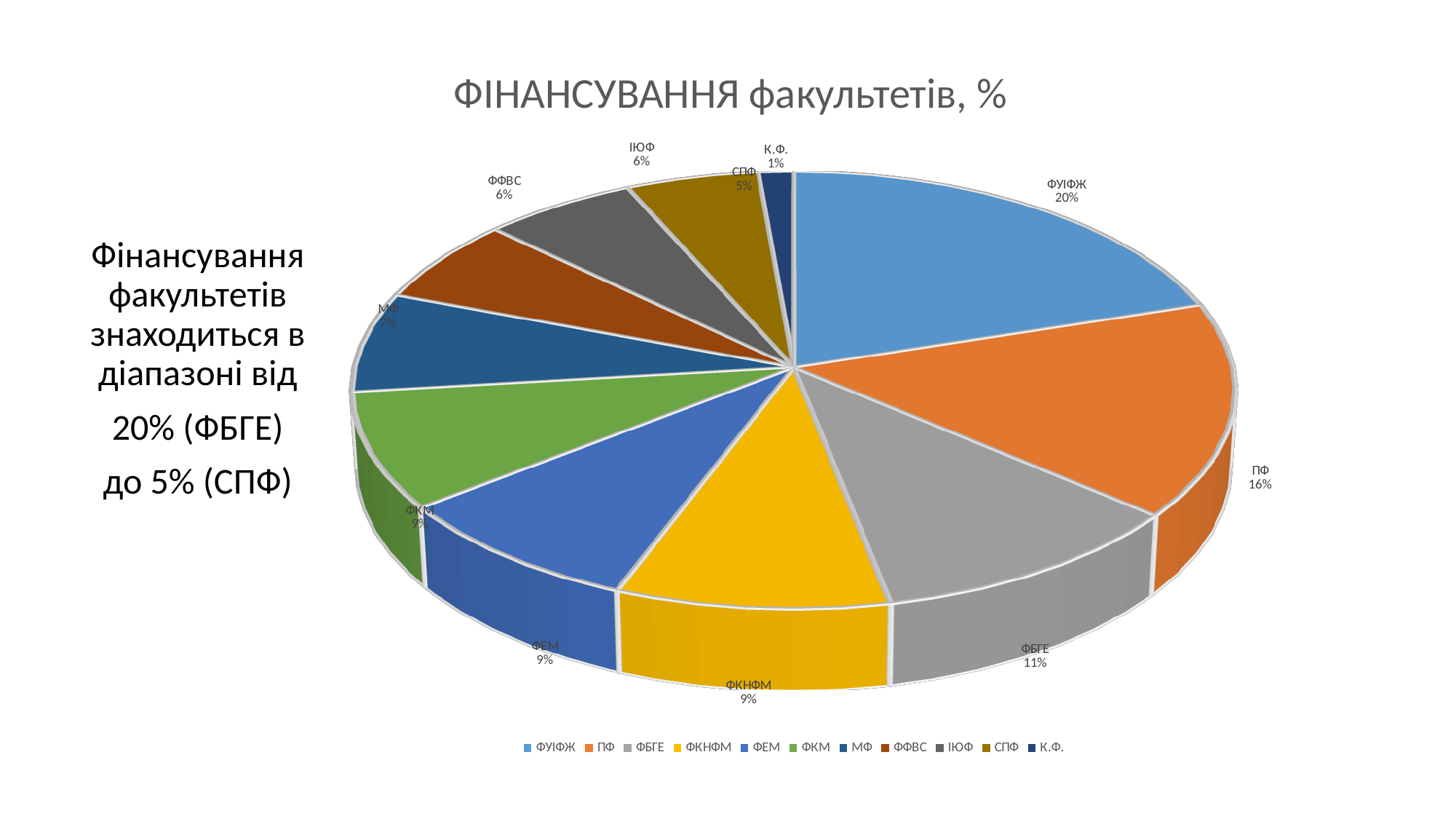
What is the difference between the values for ФУІФЖ and ПФ? 4% Which category has the largest slice of the pie? ФУІФЖ What is the value shown for СПФ? 5% What is the value shown for ФКНФМ? 9% How many categories does the legend list? 11 Which is larger, the value for МФ or the value for ФКМ? ФКМ Which category has the smallest slice of the pie? К.Ф. What share of the pie does ФУІФЖ have? 20% What is the value shown for ФБГЕ? 11% What type of chart is shown on the slide? pie chart What is the title of the chart? ФІНАНСУВАННЯ факультетів, % What is the value shown for ПФ? 16%